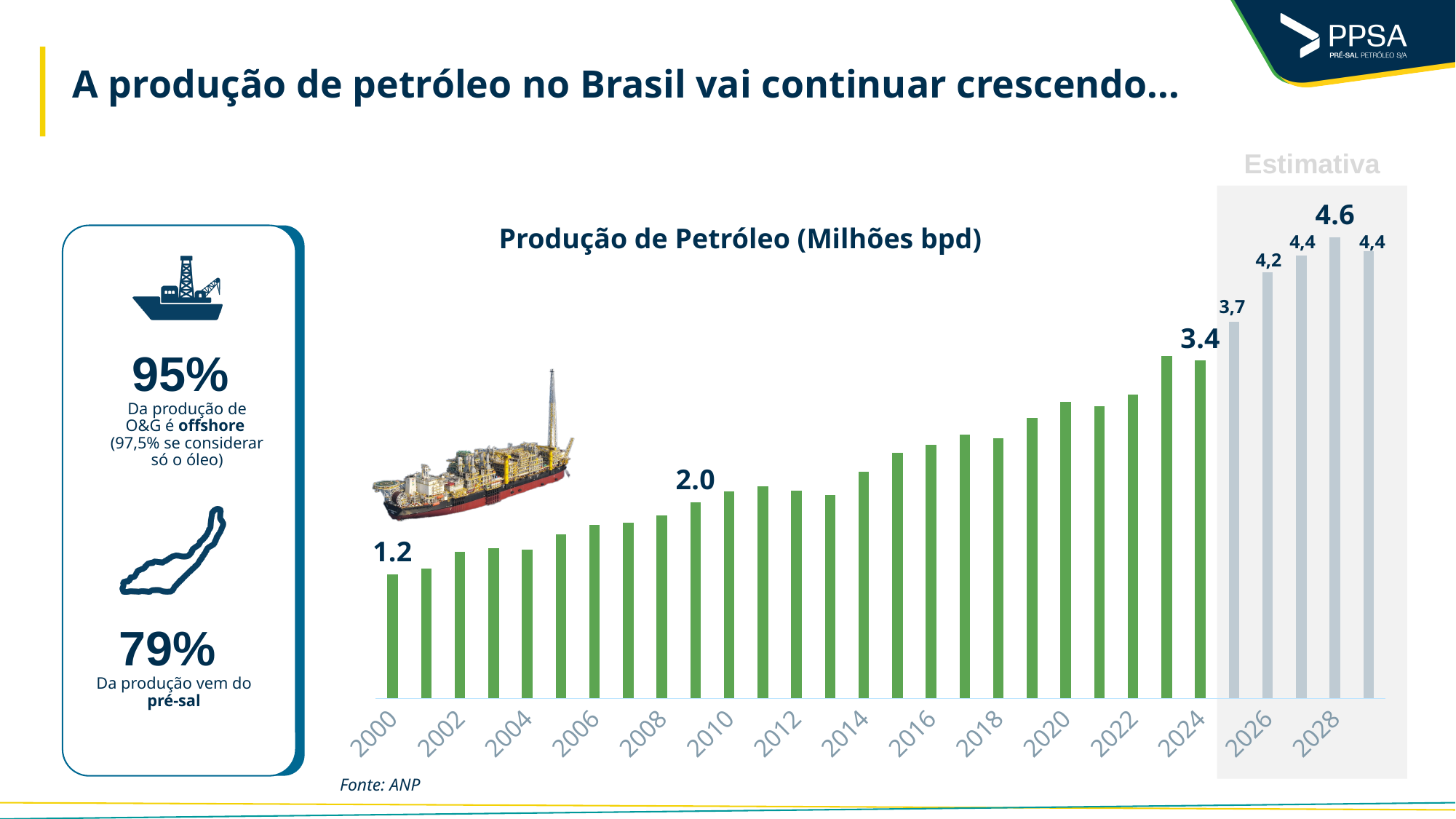
Which is larger, the value for 2026 or the value for 2029? 2029 What is the oil production value labelled for 2009? 2.0 What is the oil production value shown for 2024? 3.4 Which year has the lowest bar in the chart? 2000 What is the estimated oil production value for 2025? 3,7 What is the difference between the 2024 value and the 2000 value? 2.2 What kind of chart is shown on the slide? Bar chart Which year has the highest bar in the chart? 2028 Do the values generally rise or fall from 2000 to 2028? Rise What is the oil production value shown for 2000? 1.2 What is the estimated oil production value for 2028? 4.6 What is the title of the chart? Produção de Petróleo (Milhões bpd)